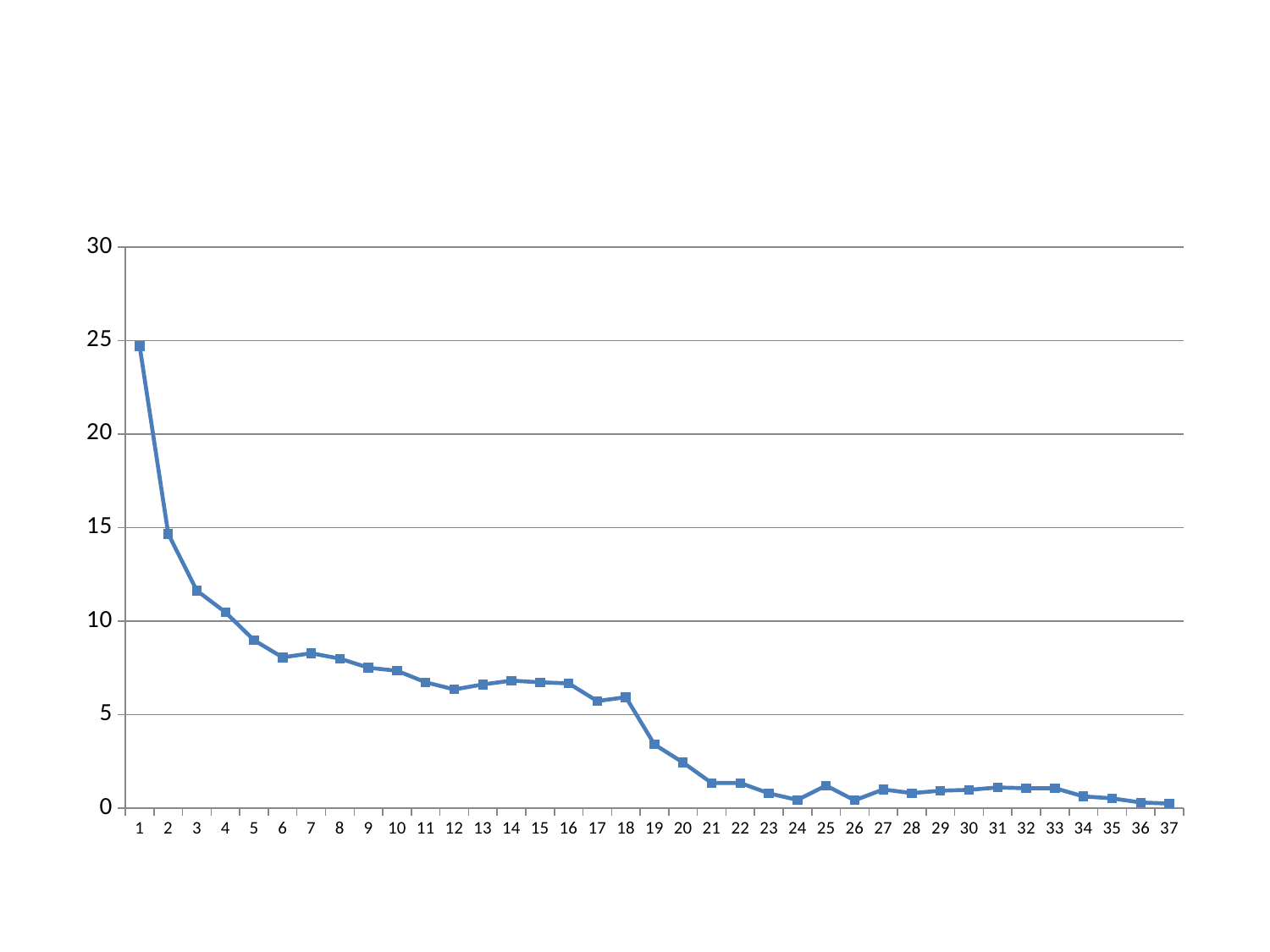
Which x-axis category has the highest value? 1 How many points are plotted along the x axis? 37 Is the value at x = 5 greater or less than 10? less Is the value at x = 1 greater or less than 20? greater Do the values generally rise or fall as you move from 1 to 37 along the x axis? fall Is the value at x = 19 greater or less than 5? less What kind of chart is shown on the slide? line chart What is the highest value shown on the y axis? 30 Which has the larger value, x = 1 or x = 2? 1 Which has the larger value, x = 18 or x = 19? 18